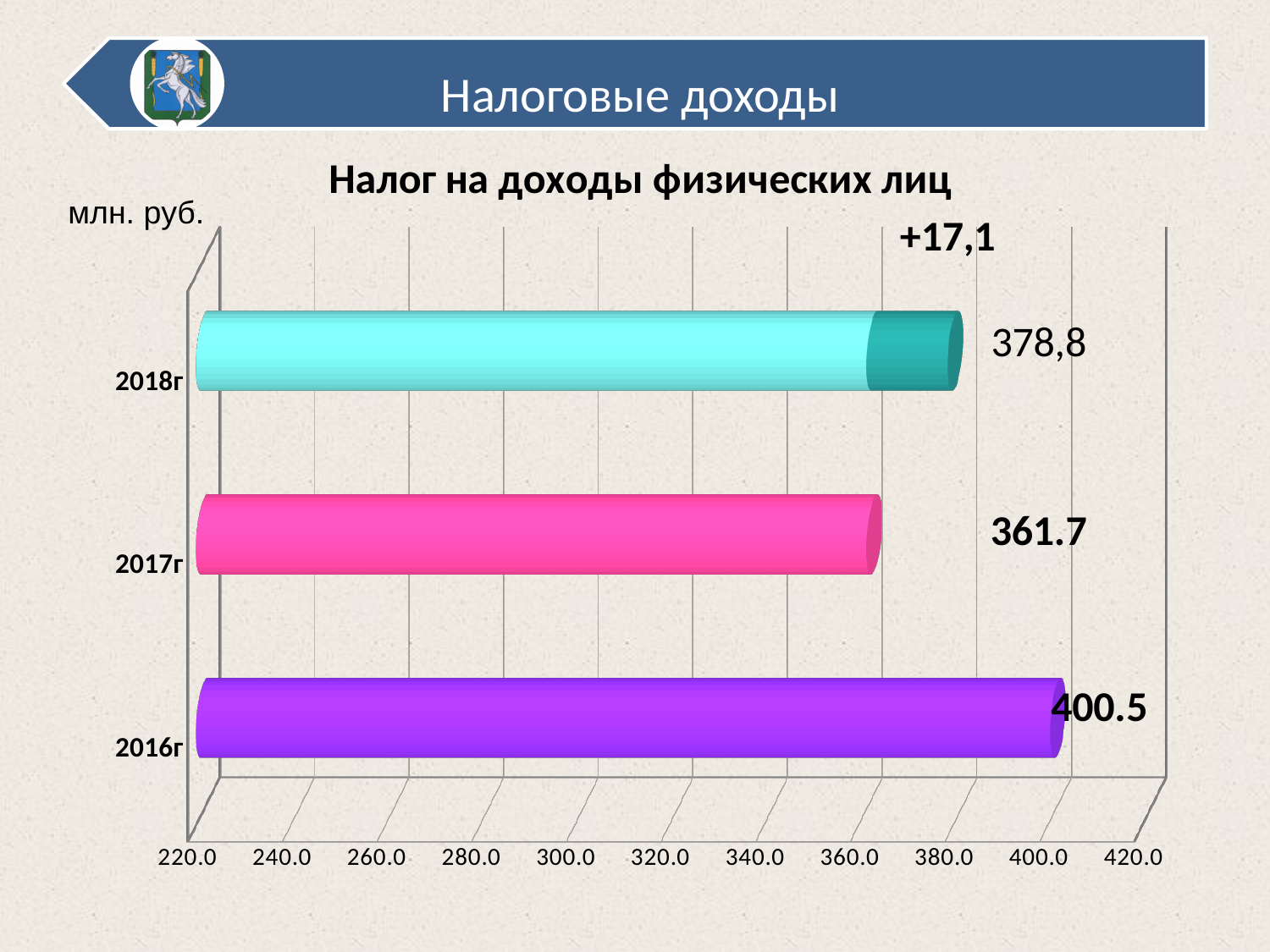
What is the value for 2017г? 361.7 What is the value for 2018г? 378,8 What is the difference between the values for 2018г and 2017г? 17,1 Is the value for 2017г greater or less than 340? greater What is the difference between the values for 2016г and 2017г? 38.8 Which year has the lowest value? 2017г What kind of chart is shown on the slide? bar chart How many years are shown in the chart? 3 Which year has the highest value? 2016г Which is larger, the value for 2016г or the value for 2018г? 2016г What is the title of the chart? Налог на доходы физических лиц What is the value for 2016г? 400.5